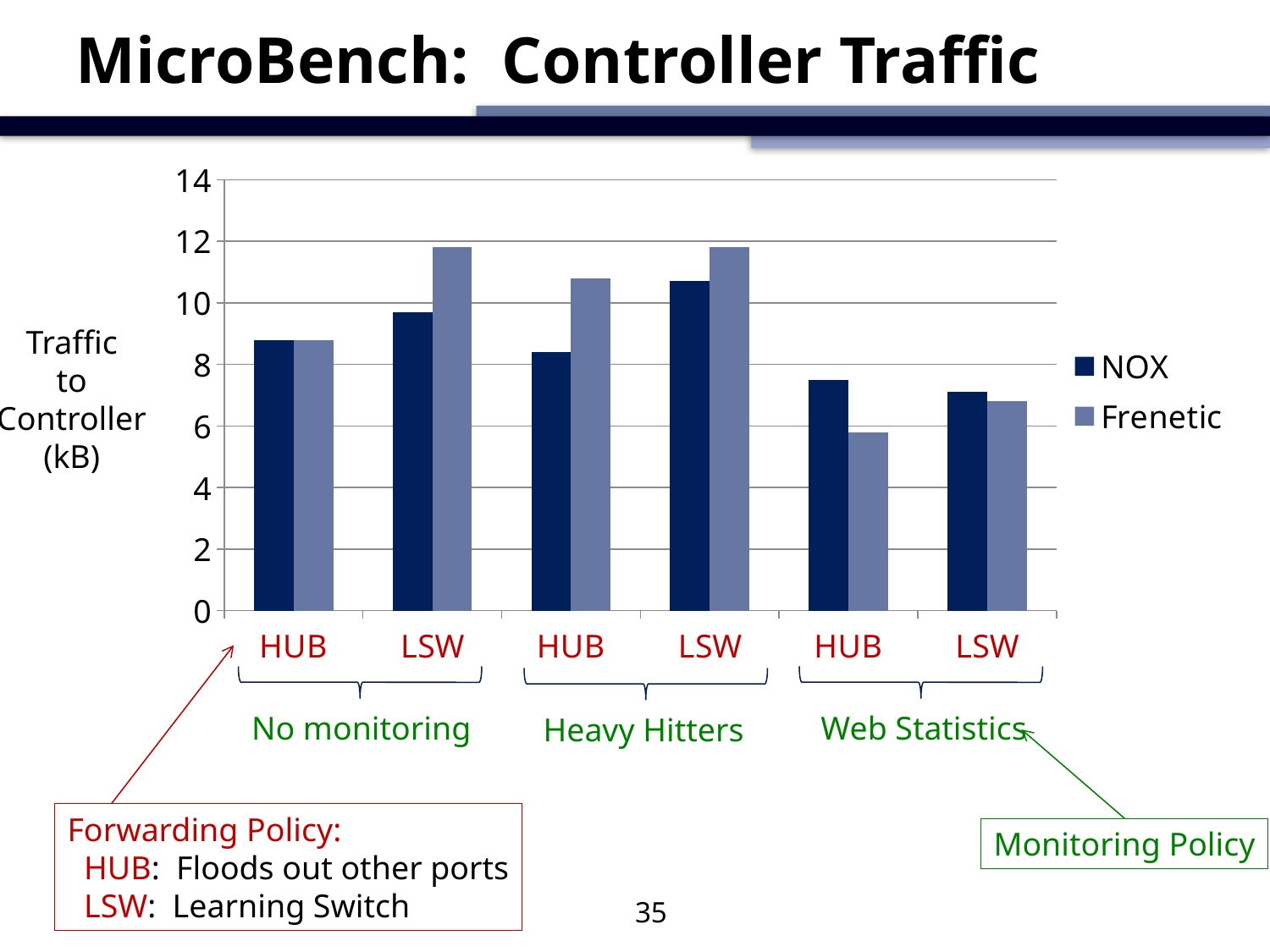
Is the NOX value for LSW under Heavy Hitters greater or less than 10? greater For HUB under Heavy Hitters, which is larger: NOX or Frenetic? Frenetic How many category groups (HUB/LSW pairs) are plotted along the x axis? 3 Is the NOX value for HUB under Web Statistics greater or less than 8? less What are the two series named in the legend? NOX and Frenetic For HUB under Web Statistics, which is larger: NOX or Frenetic? NOX What is the label on the y axis of the chart? Traffic to Controller (kB) What kind of chart is shown on the slide? bar chart Which bar in the chart is the lowest? Frenetic for HUB under Web Statistics How many series does the legend list? 2 Is the Frenetic value for LSW under No monitoring greater or less than 10? greater